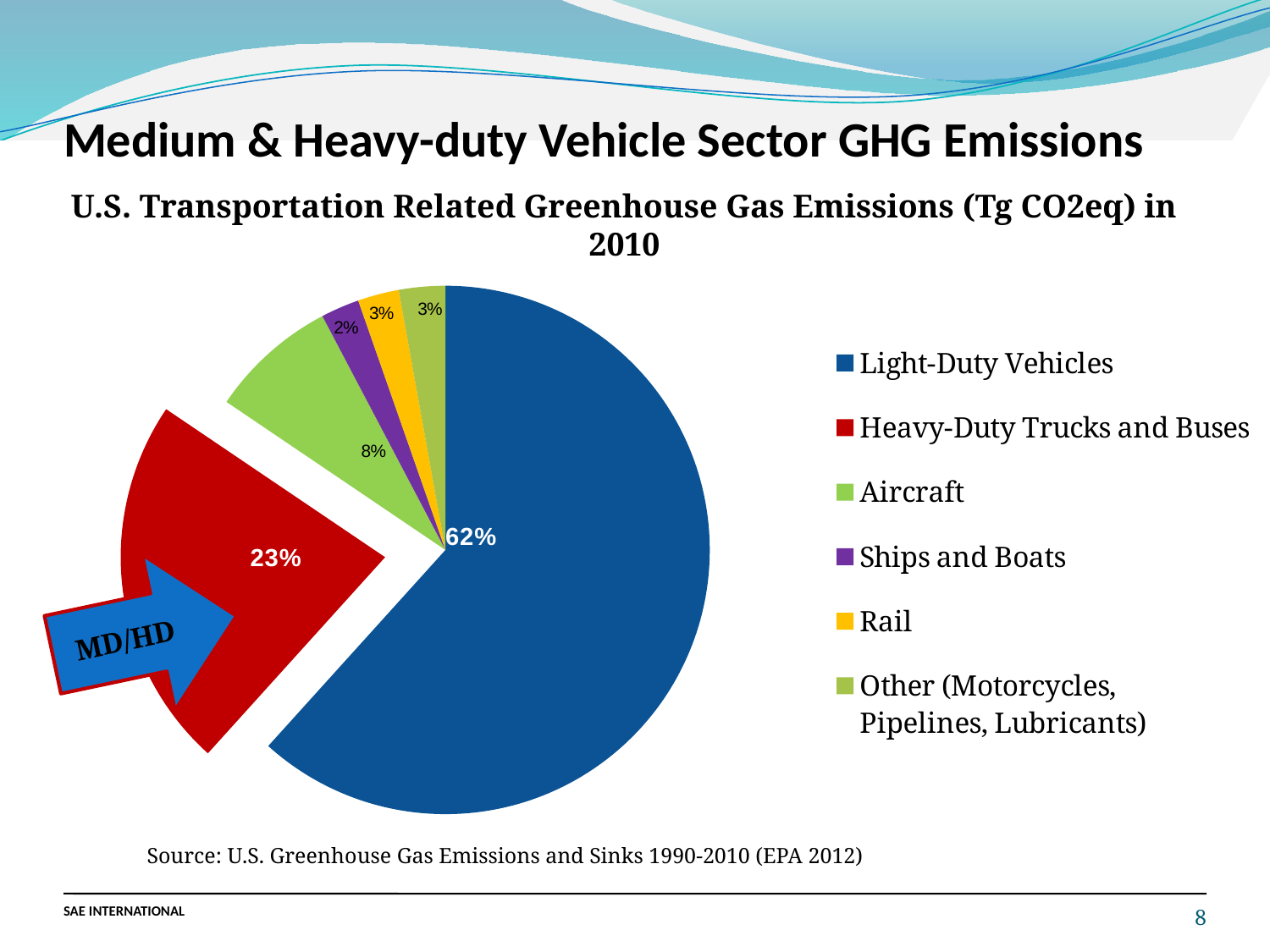
Which category has the largest slice of the pie? Light-Duty Vehicles What share does Aircraft account for in the pie chart? 8% What type of chart is shown on the slide? Pie chart What percentage is shown for Ships and Boats? 2% What is the difference in percentage points between Light-Duty Vehicles and Heavy-Duty Trucks and Buses? 39 percentage points What percentage of the pie is Heavy-Duty Trucks and Buses? 23% What is the title of the pie chart? U.S. Transportation Related Greenhouse Gas Emissions (Tg CO2eq) in 2010 What share of U.S. transportation greenhouse gas emissions in 2010 comes from Light-Duty Vehicles? 62% Which category has the smallest slice of the pie? Ships and Boats What share of emissions is attributed to Rail? 3% How many categories does the legend list? 6 Which is larger, the share for Aircraft or the share for Rail? Aircraft